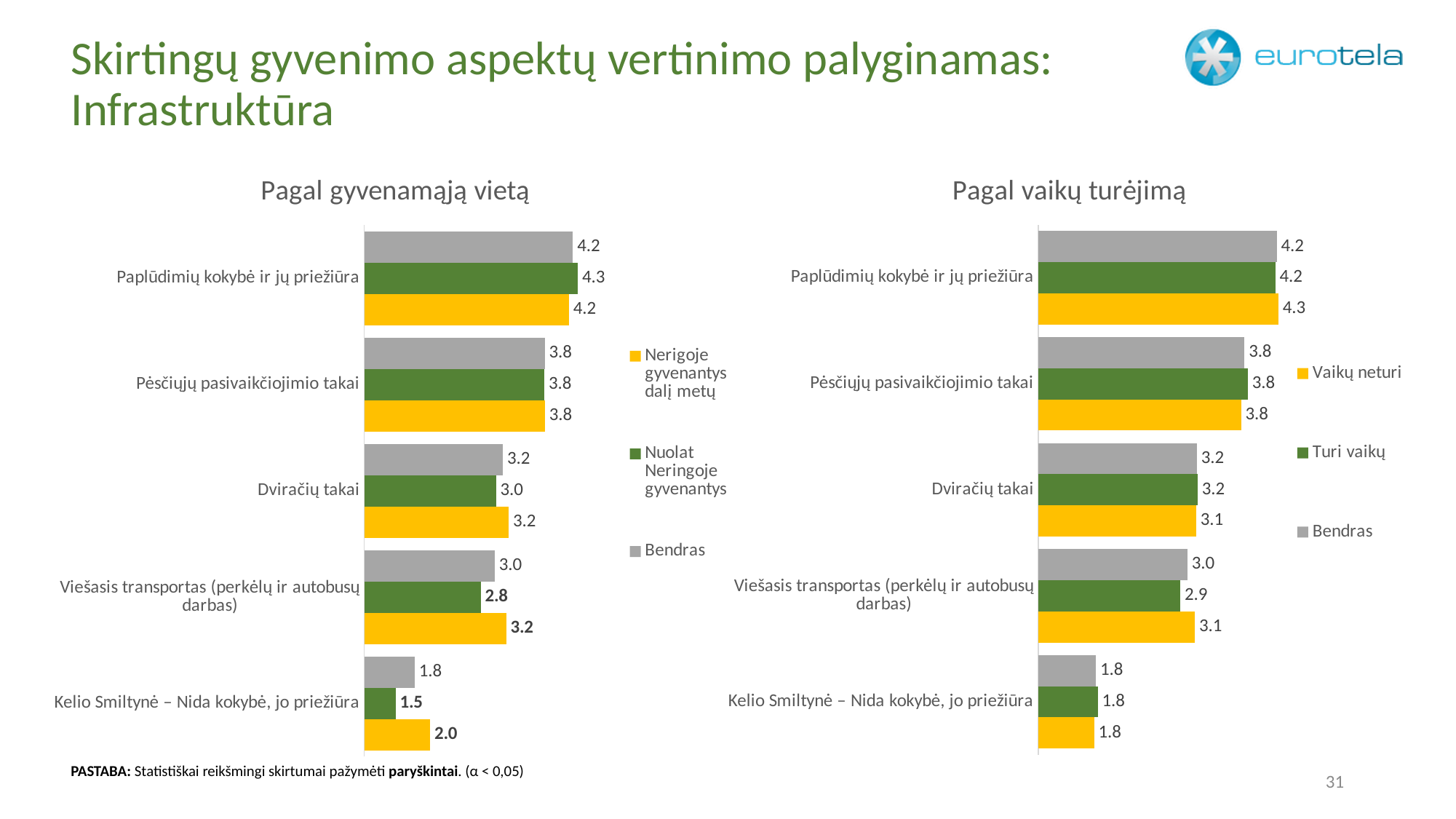
How many categories are shown in the 'Pagal vaikų turėjimą' chart? 5 In the 'Pagal vaikų turėjimą' chart, what is the value for 'Turi vaikų' for 'Viešasis transportas (perkėlų ir autobusų darbas)'? 2.9 In the 'Pagal gyvenamąją vietą' chart, what is the value for 'Nuolat Neringoje gyvenantys' for 'Kelio Smiltynė – Nida kokybė, jo priežiūra'? 1.5 In the 'Pagal gyvenamąją vietą' chart, what is the difference between the 'Nerigoje gyvenantys dalį metų' and 'Nuolat Neringoje gyvenantys' values for 'Kelio Smiltynė – Nida kokybė, jo priežiūra'? 0.5 In the 'Pagal vaikų turėjimą' chart, which category has the highest 'Turi vaikų' value? Paplūdimių kokybė ir jų priežiūra In the 'Pagal vaikų turėjimą' chart, what is the value for 'Vaikų neturi' for 'Paplūdimių kokybė ir jų priežiūra'? 4.3 In the 'Pagal gyvenamąją vietą' chart, for 'Viešasis transportas (perkėlų ir autobusų darbas)', which is larger: the 'Bendras' value or the 'Nuolat Neringoje gyvenantys' value? Bendras What type of chart is the 'Pagal vaikų turėjimą' chart? Bar chart How many series does the legend of the 'Pagal gyvenamąją vietą' chart list? 3 In the 'Pagal gyvenamąją vietą' chart, what is the value for 'Nerigoje gyvenantys dalį metų' for 'Viešasis transportas (perkėlų ir autobusų darbas)'? 3.2 In the 'Pagal gyvenamąją vietą' chart, which category has the lowest 'Bendras' value? Kelio Smiltynė – Nida kokybė, jo priežiūra In the 'Pagal vaikų turėjimą' chart, for 'Dviračių takai', which is larger: the 'Turi vaikų' value or the 'Vaikų neturi' value? Turi vaikų